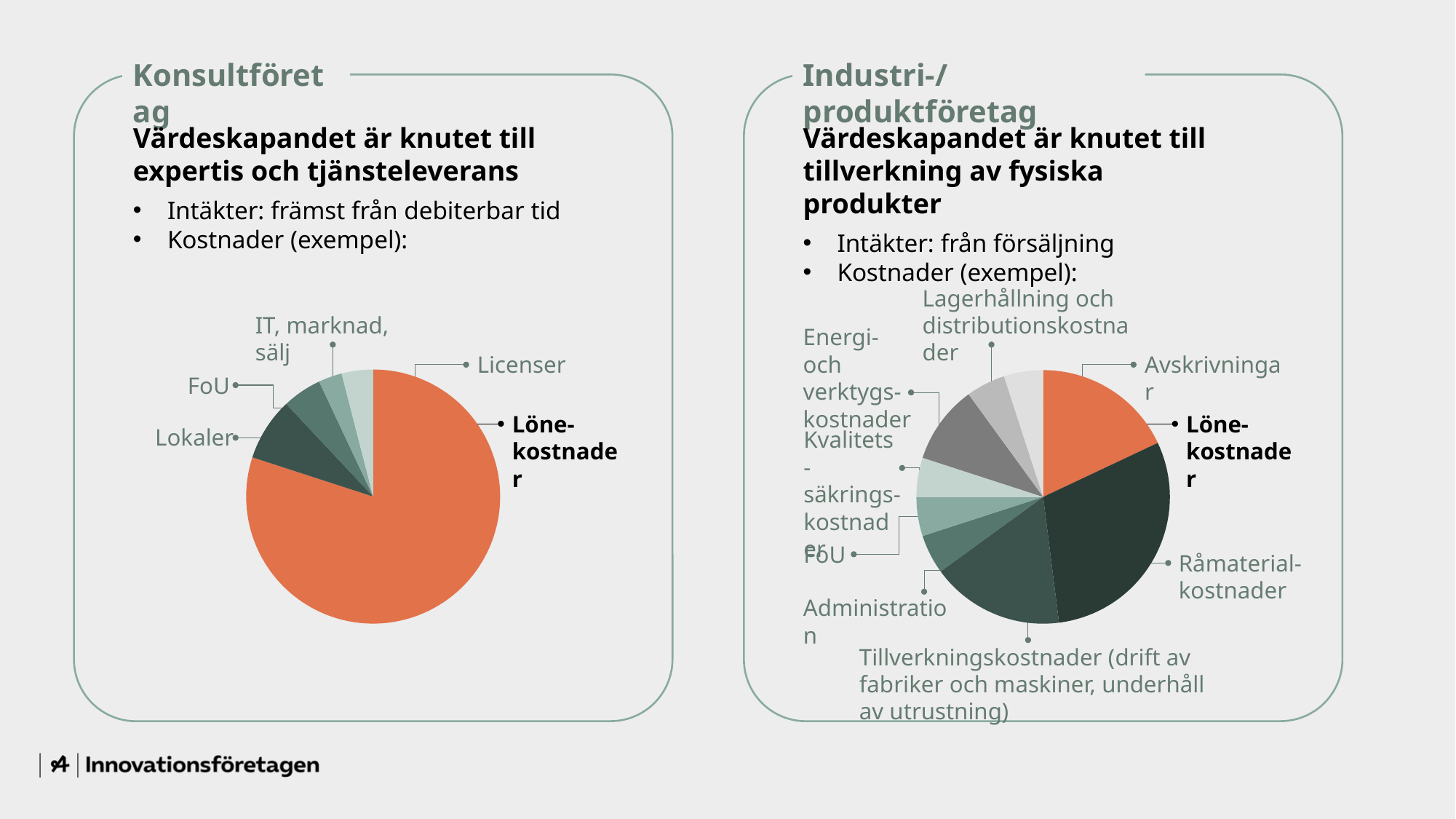
How many charts are on the slide? 2 In the Konsultföretag pie chart, which slice is larger, Lönekostnader or Lokaler? Lönekostnader Which cost category label appears in bold in both pie charts? Lönekostnader In the Konsultföretag pie chart, which cost category has the largest slice? Lönekostnader In the Konsultföretag pie chart, how many cost categories (slices) are labelled? 5 What kind of chart is shown in the Konsultföretag box? Pie chart What kind of chart is shown in the Industri-/produktföretag box? Pie chart In the Industri-/produktföretag pie chart, how many cost categories (slices) are labelled? 9 In the Konsultföretag pie chart, what colour is the Lönekostnader slice? Orange In the Konsultföretag pie chart, which slice is larger, Lönekostnader or FoU? Lönekostnader